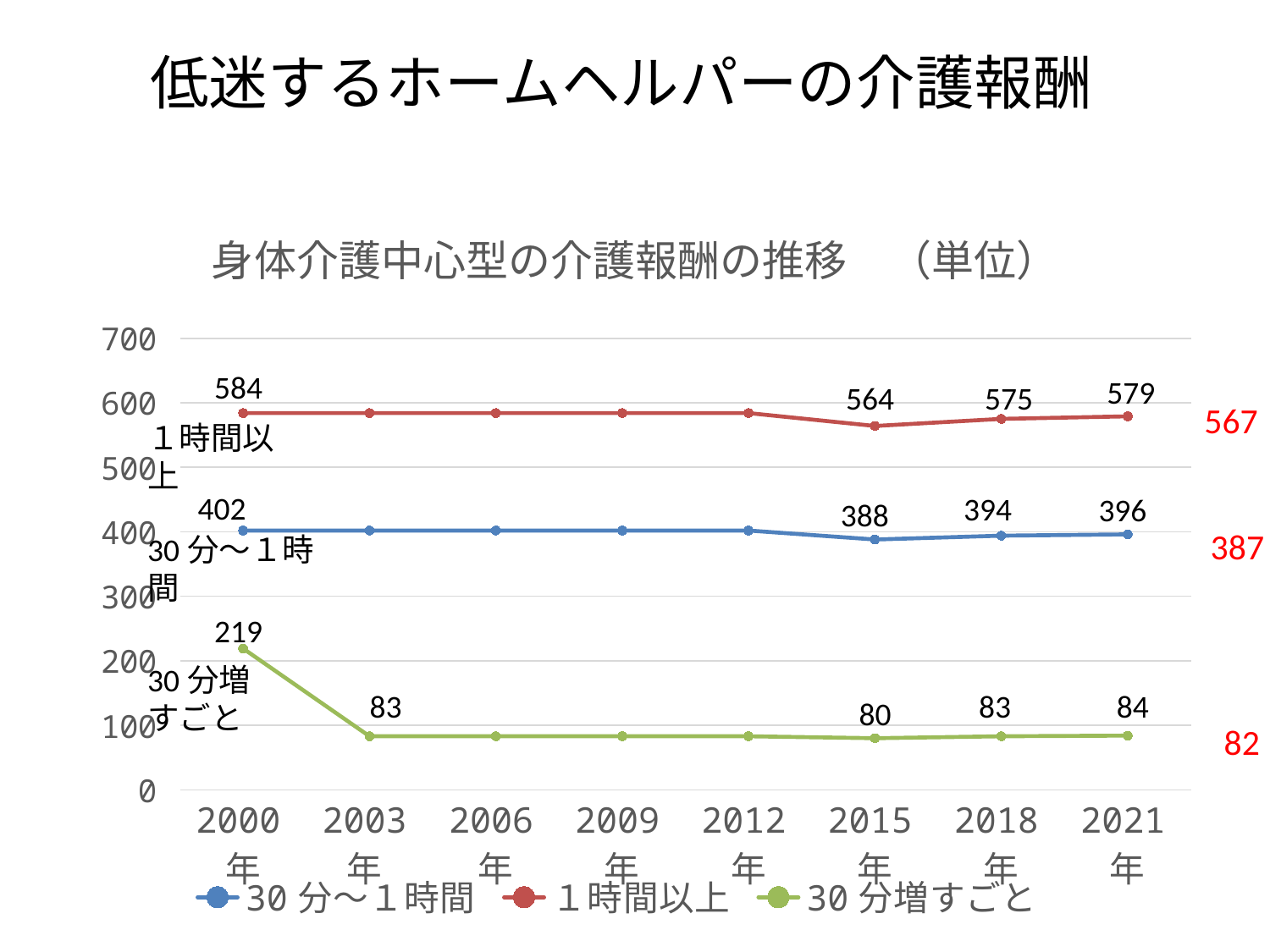
In which year does the 30分増すごと series reach its lowest labeled value? 2015年 By how much did the 1時間以上 series increase from 2015年 to 2021年? 15 Is the value of the 30分増すごと series larger in 2015年 or 2021年? 2021年 What is the value of the 30分増すごと series in 2003年? 83 What is the value of the 30分～1時間 series in 2015年? 388 By how much did the 30分増すごと series fall from 2000年 to 2003年? 136 Is the value for 30分～1時間 in 2006年 greater or less than 300? greater How many series does the legend list? 3 What is the value of the 1時間以上 series in 2000年? 584 Which series has the highest values throughout the chart? 1時間以上 What is the value of the 1時間以上 series in 2021年? 579 How many years are shown on the x axis? 8